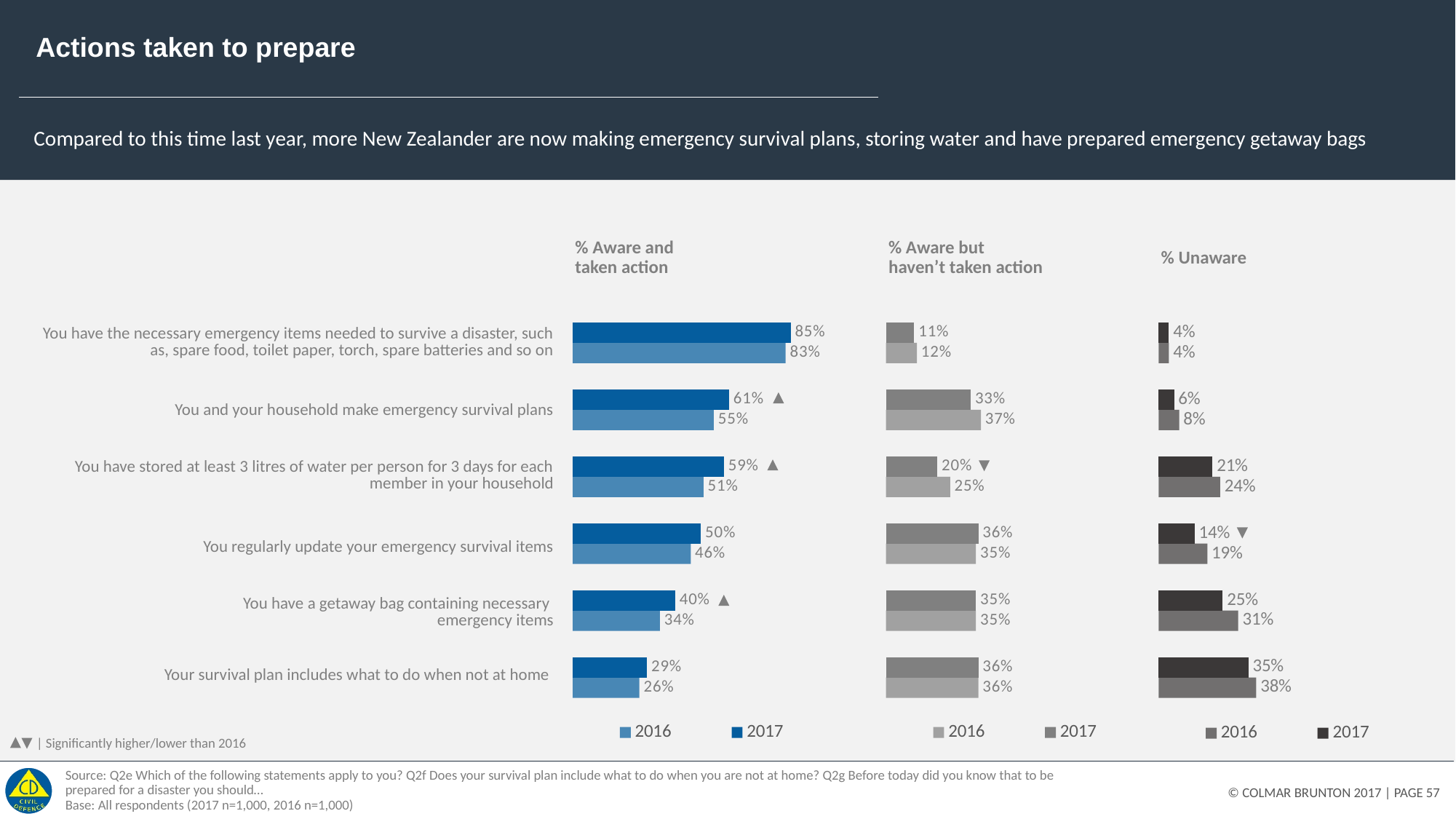
How many series does the legend of the '% Aware but haven't taken action' chart list? 2 In the '% Aware and taken action' chart, what is the 2016 value for 'You have a getaway bag containing necessary emergency items'? 34% In the '% Aware and taken action' chart, what is the difference between the 2017 and 2016 values for 'You have stored at least 3 litres of water per person for 3 days for each member in your household'? 8% What kind of chart is the '% Unaware' chart? Bar chart How many categories are shown in the '% Aware and taken action' chart? 6 In the '% Unaware' chart, what is the 2016 value for 'Your survival plan includes what to do when not at home'? 38% In the '% Aware and taken action' chart, which category has the highest 2017 value? You have the necessary emergency items needed to survive a disaster, such as, spare food, toilet paper, torch, spare batteries and so on In the '% Unaware' chart, which category has the lowest 2017 value? You have the necessary emergency items needed to survive a disaster, such as, spare food, toilet paper, torch, spare batteries and so on In the '% Aware and taken action' chart, what is the 2017 value for 'You and your household make emergency survival plans'? 61% In the '% Unaware' chart, which is larger for 'You regularly update your emergency survival items': the 2016 value or the 2017 value? 2016 In the '% Aware but haven't taken action' chart, what is the 2017 value for 'You have stored at least 3 litres of water per person for 3 days for each member in your household'? 20% What are the two series listed in the legend of the '% Aware and taken action' chart? 2016 and 2017